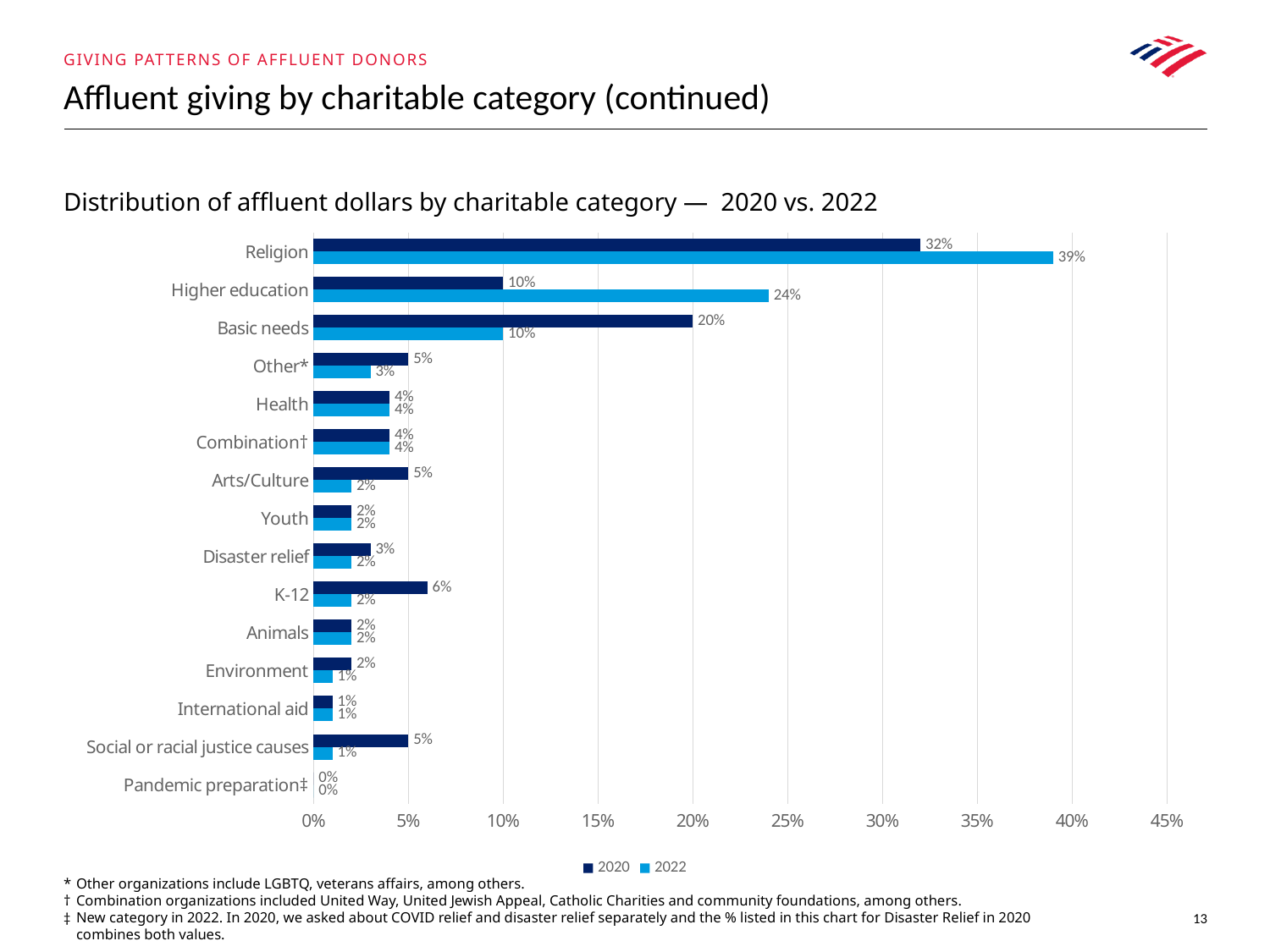
Which category has the lowest 2020 value? Pandemic preparation‡ What is the 2022 value for Basic needs? 10% Which is larger for Basic needs, the 2020 value or the 2022 value? 2020 How many charitable categories are shown on the chart? 15 What is the title of the chart? Distribution of affluent dollars by charitable category — 2020 vs. 2022 What kind of chart is shown on the slide? Bar chart Is the 2020 value for Religion greater or less than 30%? greater What is the difference between the 2022 and 2020 values for Higher education? 14% Which category has the highest 2022 value? Religion What is the 2020 value for Higher education? 10% How many series does the legend list? 2 What is the 2022 value for Religion? 39%